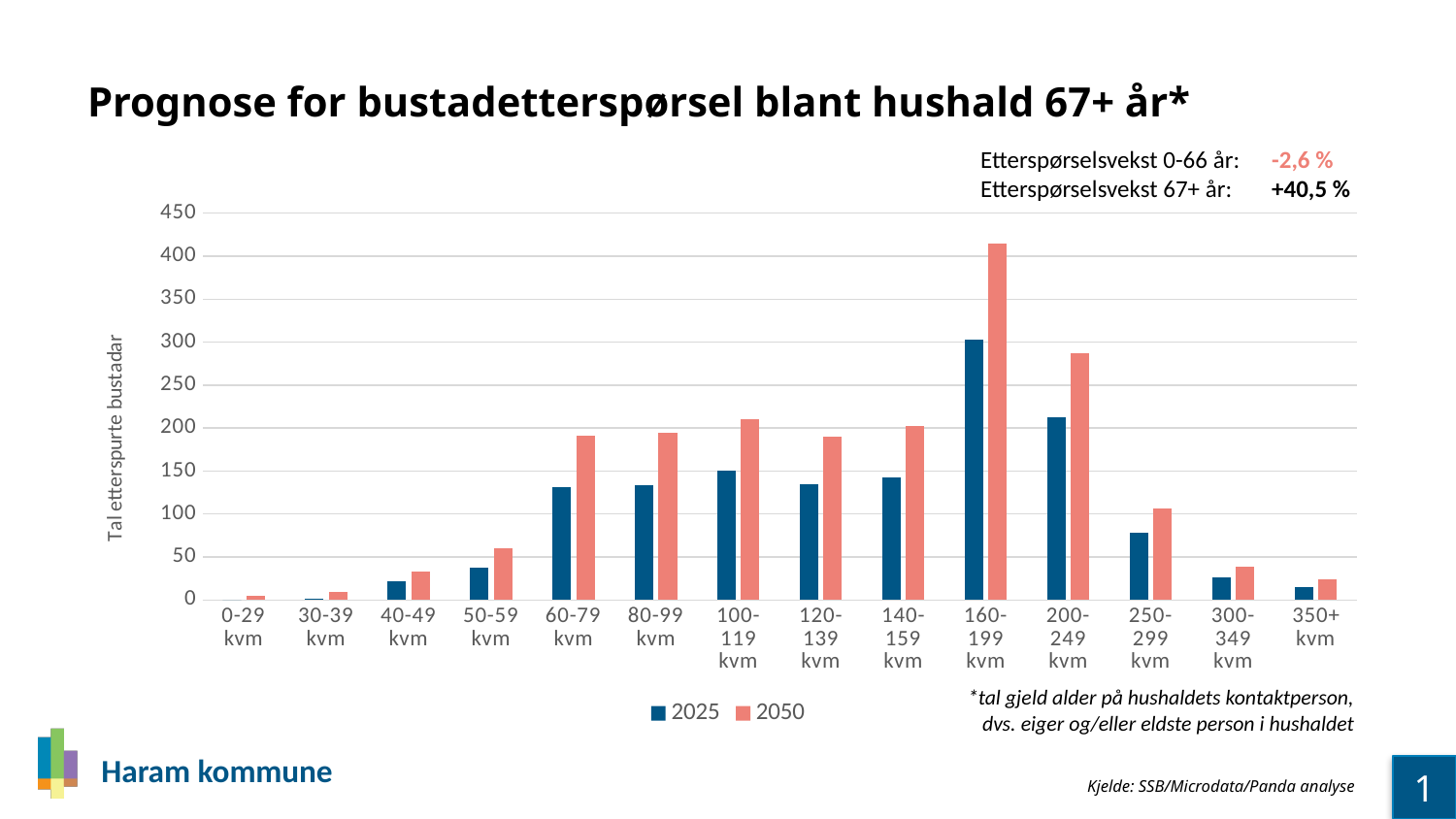
For the 160-199 kvm category, which series has the larger value, 2025 or 2050? 2050 How many series does the legend list? 2 How many size categories are shown on the x axis? 14 Which size category has the highest value for the 2050 series? 160-199 kvm Is the 2025 value for 50-59 kvm greater or less than 50? less What kind of chart is shown on the slide? bar chart What is the title of the chart? Prognose for bustadetterspørsel blant hushald 67+ år* For the 2025 series, which is larger: the value for 200-249 kvm or the value for 140-159 kvm? 200-249 kvm Is the 2050 value for 60-79 kvm greater or less than 200? less Is the 2050 value for 200-249 kvm greater or less than 300? less Which size category has the highest value for the 2025 series? 160-199 kvm